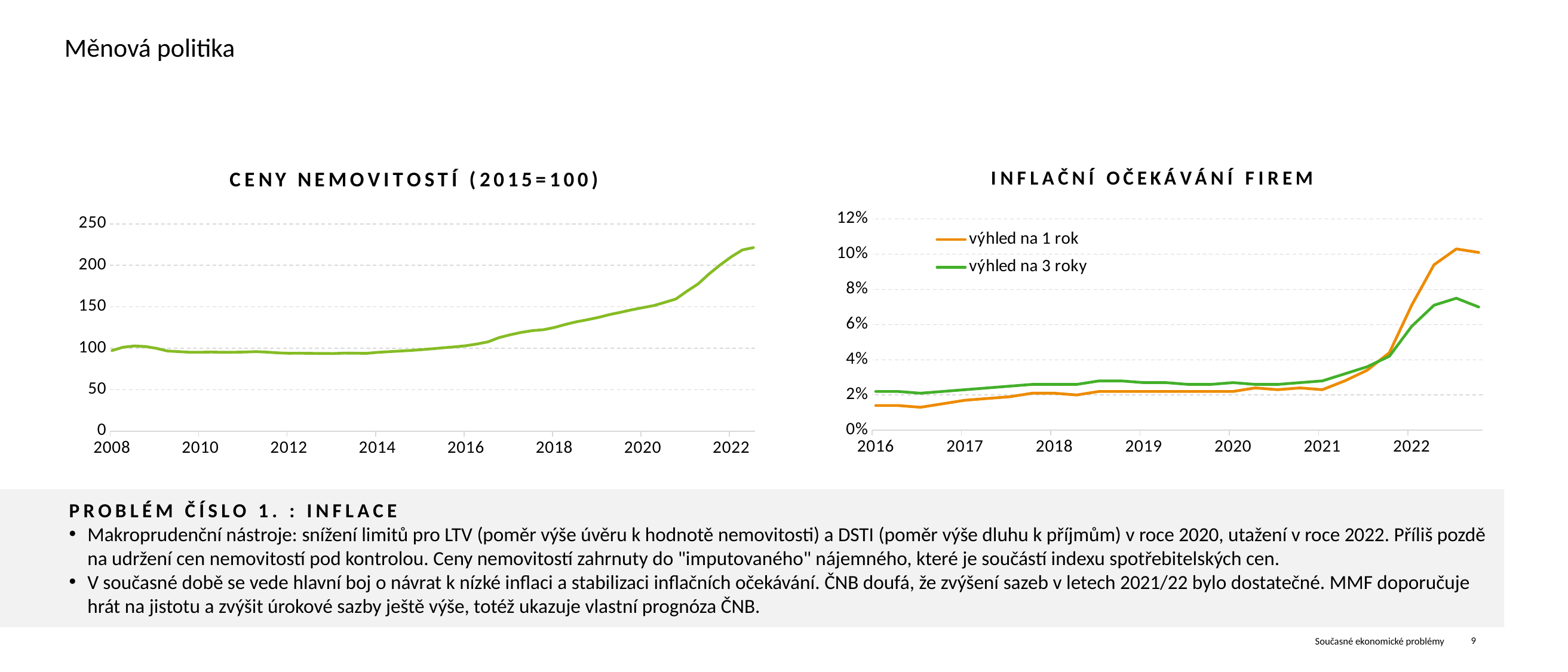
In the chart "INFLAČNÍ OČEKÁVÁNÍ FIREM", which series has the higher value at 2022, "výhled na 1 rok" or "výhled na 3 roky"? výhled na 1 rok In the chart "CENY NEMOVITOSTÍ (2015=100)", do the values overall rise or fall between 2016 and 2022? rise In the chart "INFLAČNÍ OČEKÁVÁNÍ FIREM", which series is drawn in orange? výhled na 1 rok In the chart "INFLAČNÍ OČEKÁVÁNÍ FIREM", which series has the higher value at 2016, "výhled na 1 rok" or "výhled na 3 roky"? výhled na 3 roky What kind of chart is the left chart titled "CENY NEMOVITOSTÍ (2015=100)"? line chart In the chart "CENY NEMOVITOSTÍ (2015=100)", is the value at 2014 greater or less than 150? less In the chart "INFLAČNÍ OČEKÁVÁNÍ FIREM", is the value of "výhled na 3 roky" at 2022 greater or less than 8%? less In the chart "INFLAČNÍ OČEKÁVÁNÍ FIREM", how many series does the legend list? 2 In the chart "INFLAČNÍ OČEKÁVÁNÍ FIREM", which series is drawn in green? výhled na 3 roky In the chart "CENY NEMOVITOSTÍ (2015=100)", is the value at 2022 greater or less than 200? greater What kind of chart is the right chart titled "INFLAČNÍ OČEKÁVÁNÍ FIREM"? line chart